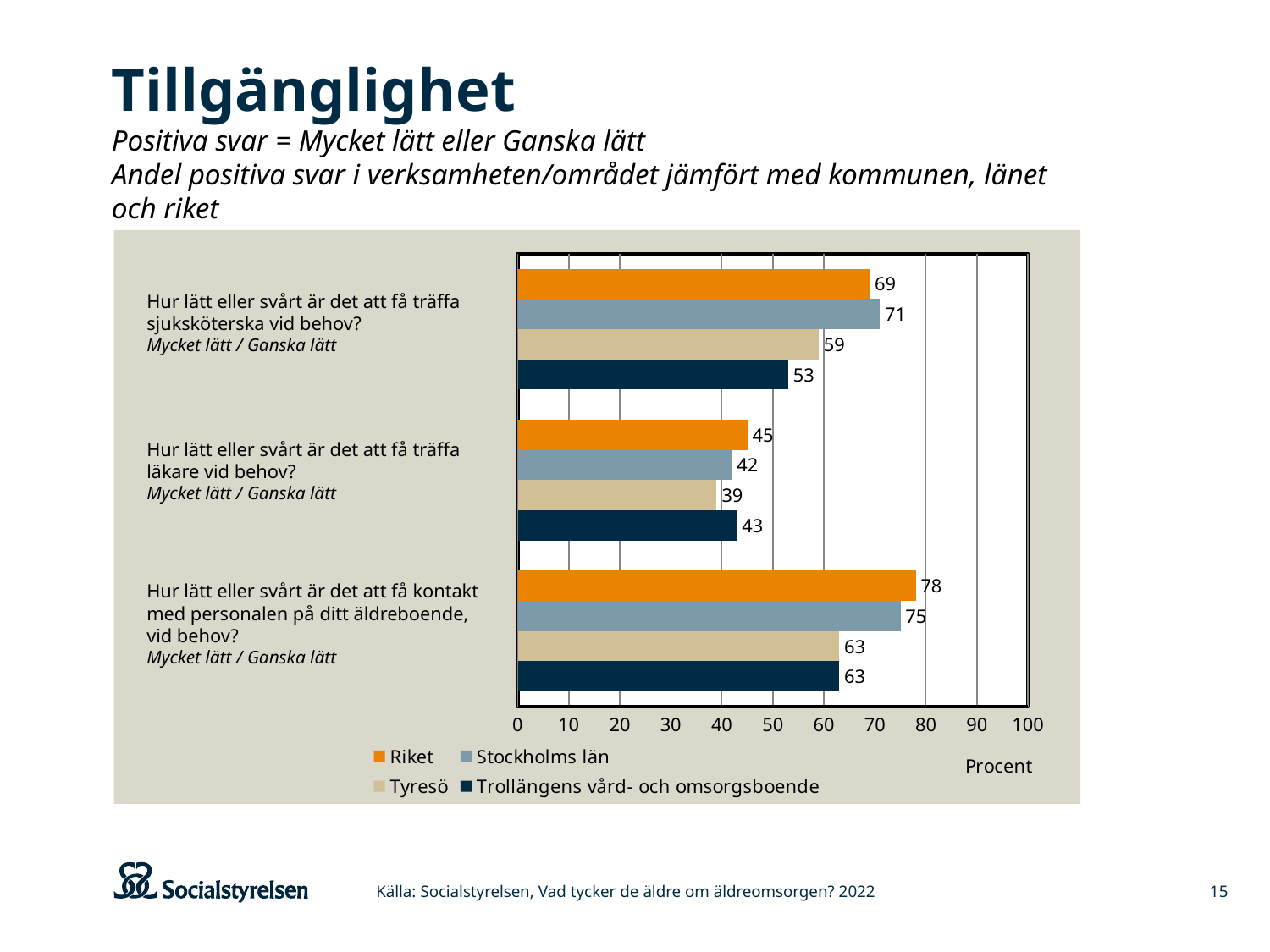
What is the label on the horizontal axis of the chart? Procent Which series has the lowest value for the question about meeting a doctor (läkare) when needed? Tyresö How many series does the legend list? 4 Is the value for Stockholms län for the question about meeting a doctor (läkare) greater or less than 50? less What is the difference between Riket and Trollängens vård- och omsorgsboende for the question about meeting a nurse (sjuksköterska)? 16 What is the value for Riket for the question about meeting a nurse (sjuksköterska) when needed? 69 What kind of chart is shown on the slide? Bar chart What is the value for Tyresö for the question about getting in contact with staff at the care home? 63 Which series has the highest value for the question about meeting a nurse (sjuksköterska) when needed? Stockholms län Which is larger for the question about contact with staff at the care home: Riket or Stockholms län? Riket What is the value for Trollängens vård- och omsorgsboende for the question about meeting a doctor (läkare) when needed? 43 How many question categories are plotted on the chart? 3